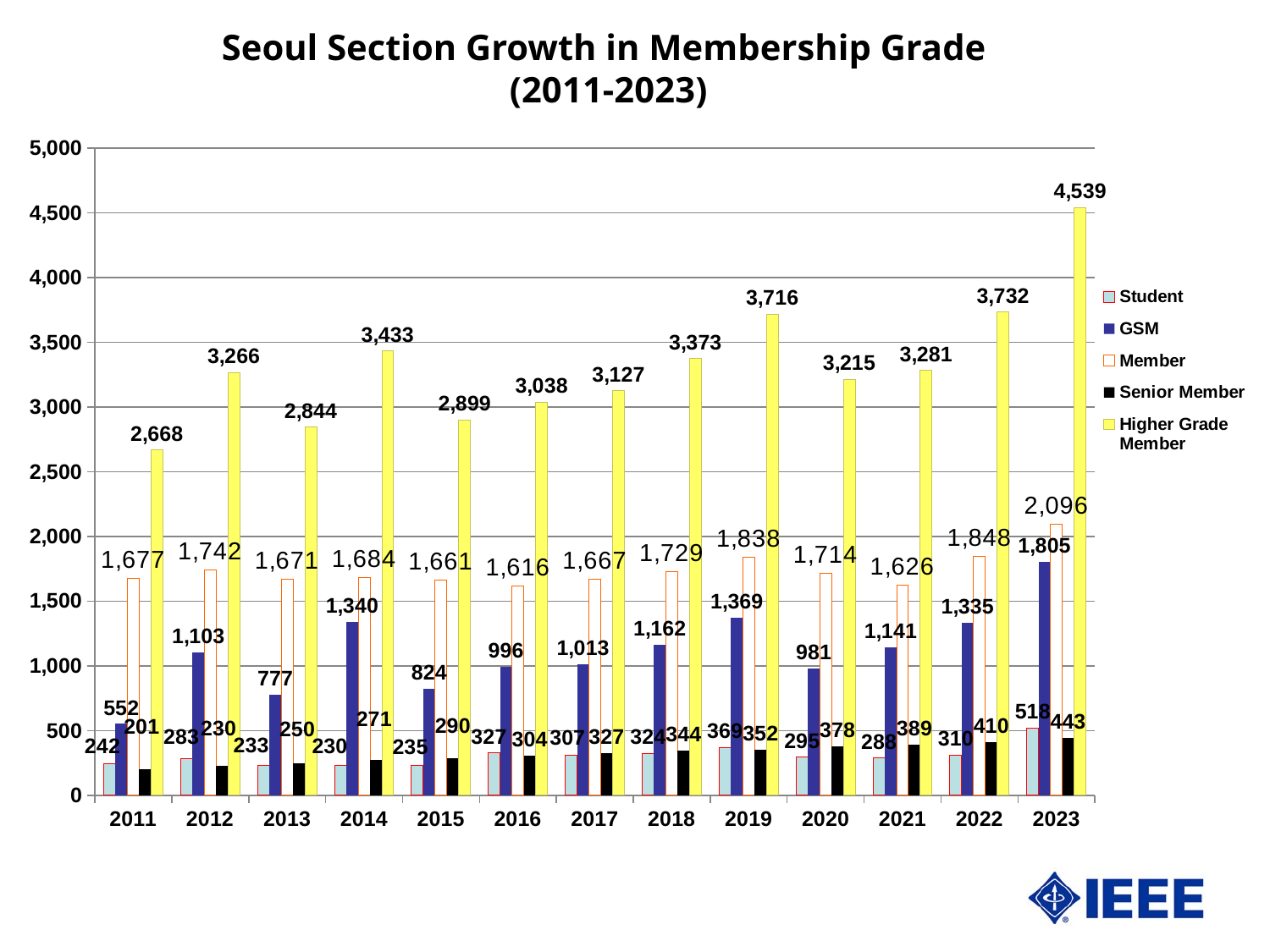
What is the value for Higher Grade Member in 2023? 4,539 How many years are shown on the x axis? 13 In which year is the Higher Grade Member value lowest? 2011 Is the GSM value in 2023 greater or less than 1,500? greater What is the difference between the Higher Grade Member values in 2023 and 2022? 807 What is the Senior Member value in 2020? 378 Which series is shown in yellow? Higher Grade Member What is the GSM value in 2014? 1,340 In which year is the Student value highest? 2023 How many series does the legend list? 5 What kind of chart is shown on the slide? bar chart Which is larger, the Member value in 2019 or the Member value in 2022? 2022